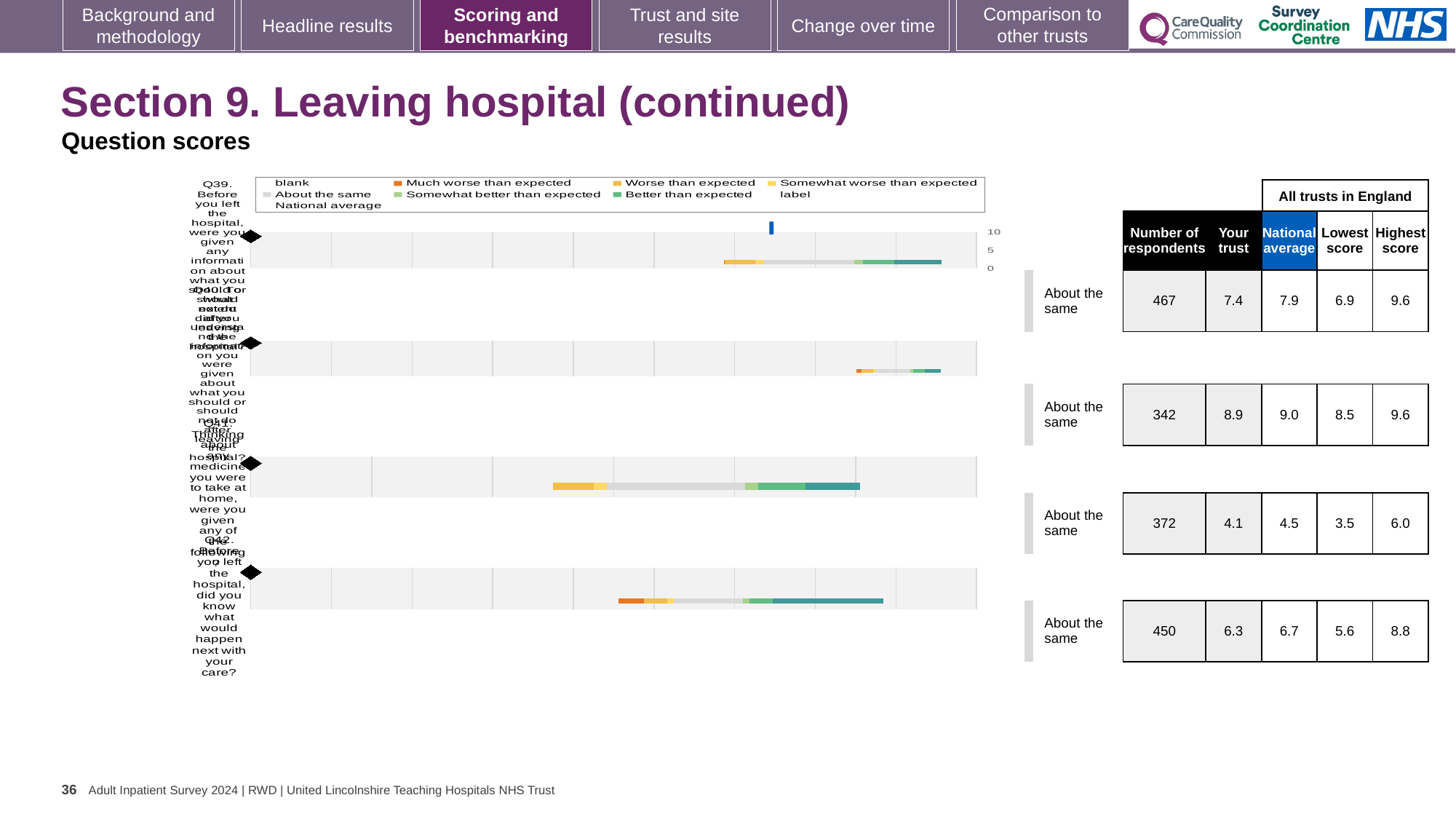
How many questions (bars) are plotted in the chart? 4 What is the 'Your trust' score for Q39 in the table beside the chart? 7.4 What is the national average for Q42 in the table beside the chart? 6.7 Which question has the highest 'Your trust' score in the table beside the chart? Q40 What is the highest score among all trusts in England for Q41? 6.0 What is the difference between the national average and the trust score for Q39? 0.5 Which legend entry is shown in orange in the chart's legend? Much worse than expected What kind of chart is used to show the question scores on this slide? bar chart What is the highest value shown on the chart's axis scale? 10 Is the trust score for Q40 larger or smaller than the trust score for Q42? larger Which question has the lowest 'Your trust' score in the table beside the chart? Q41 How many respondents answered Q41 according to the table beside the chart? 372